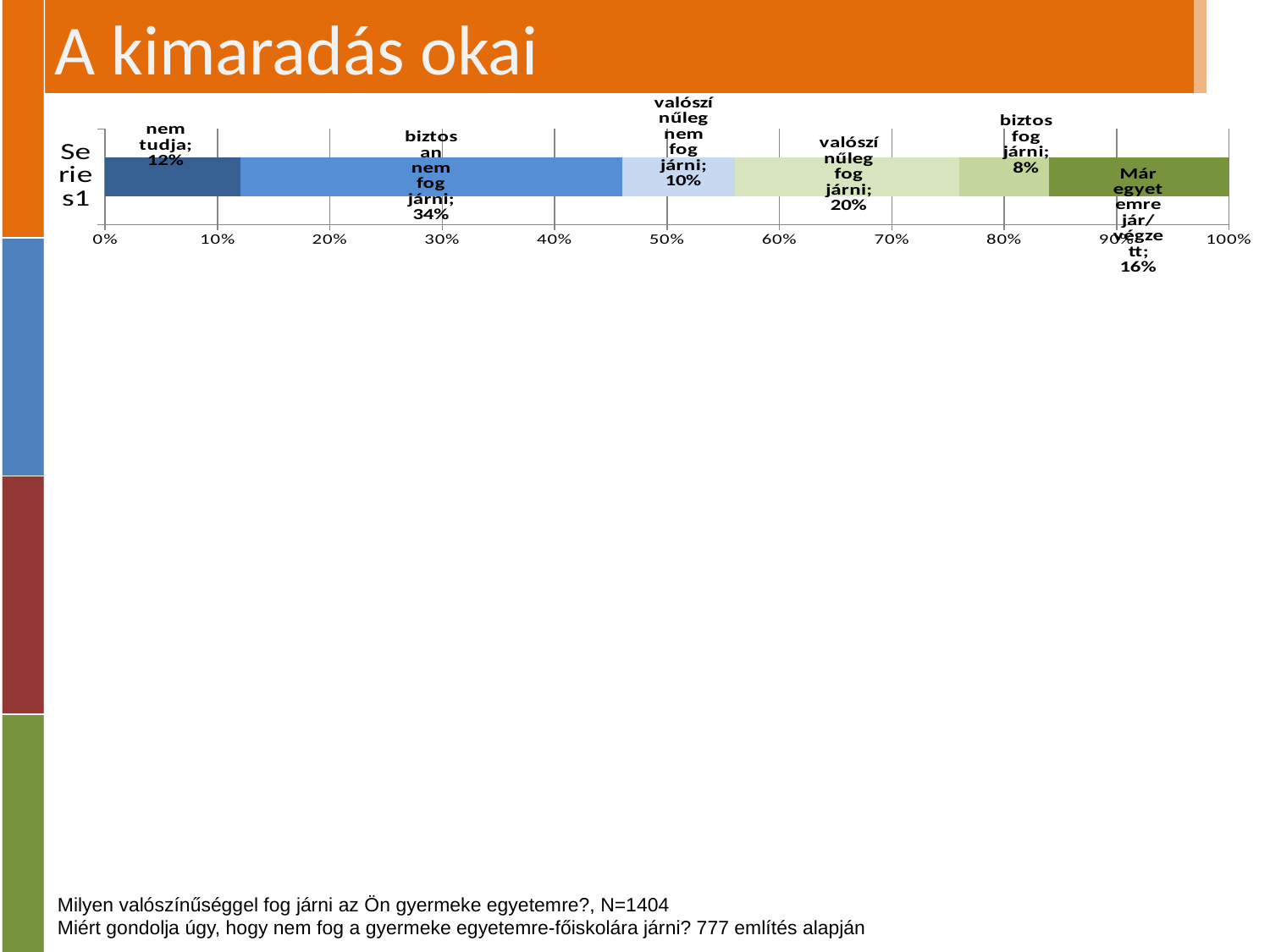
What is the value of the "biztosan nem fog járni" segment? 34% What is the value of the "Már egyetemre jár/végzett" segment? 16% What kind of chart is shown on the slide? bar chart Which is larger, the "Már egyetemre jár/végzett" segment or the "nem tudja" segment? Már egyetemre jár/végzett What is the value of the "nem tudja" segment? 12% How many segments make up the stacked bar? 6 Which segment has the smallest value? biztos fog járni What is the value of the "valószínűleg nem fog járni" segment? 10% What is the value of the "biztos fog járni" segment? 8% What is the value of the "valószínűleg fog járni" segment? 20% What is the difference between the "biztosan nem fog járni" and "valószínűleg fog járni" segments? 14% Which segment has the largest value? biztosan nem fog járni